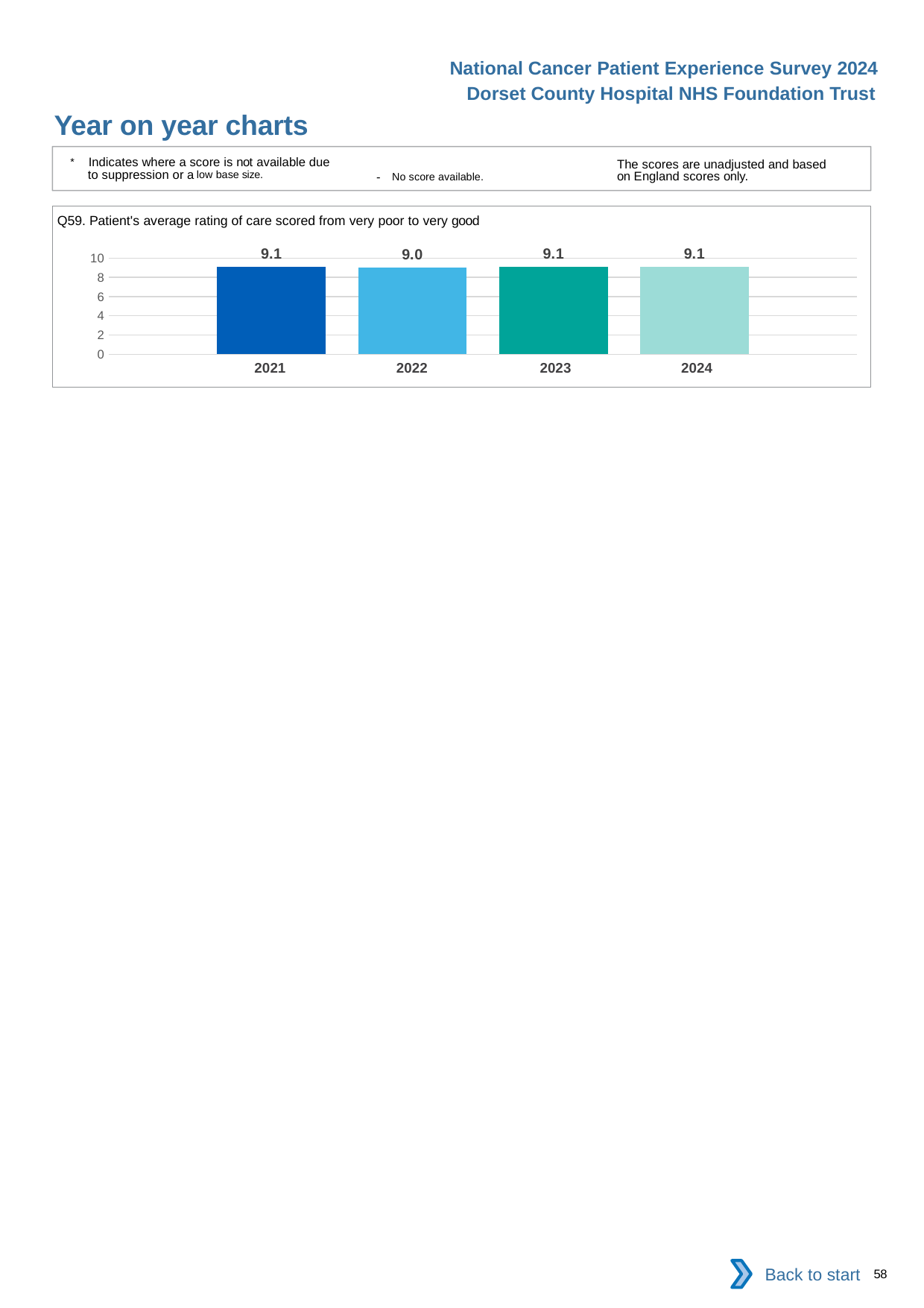
Is the value for 2023 greater or less than 8? greater How many years are shown on the x axis? 4 What is the highest value shown on the y axis? 10 What is the title of the chart? Q59. Patient's average rating of care scored from very poor to very good Which year has the lowest value? 2022 What is the value for 2022? 9.0 What is the value for 2024? 9.1 What is the value for 2021? 9.1 What kind of chart is this? bar chart Is the value for 2022 greater or less than 10? less What is the difference between the values for 2021 and 2022? 0.1 What is the value for 2023? 9.1